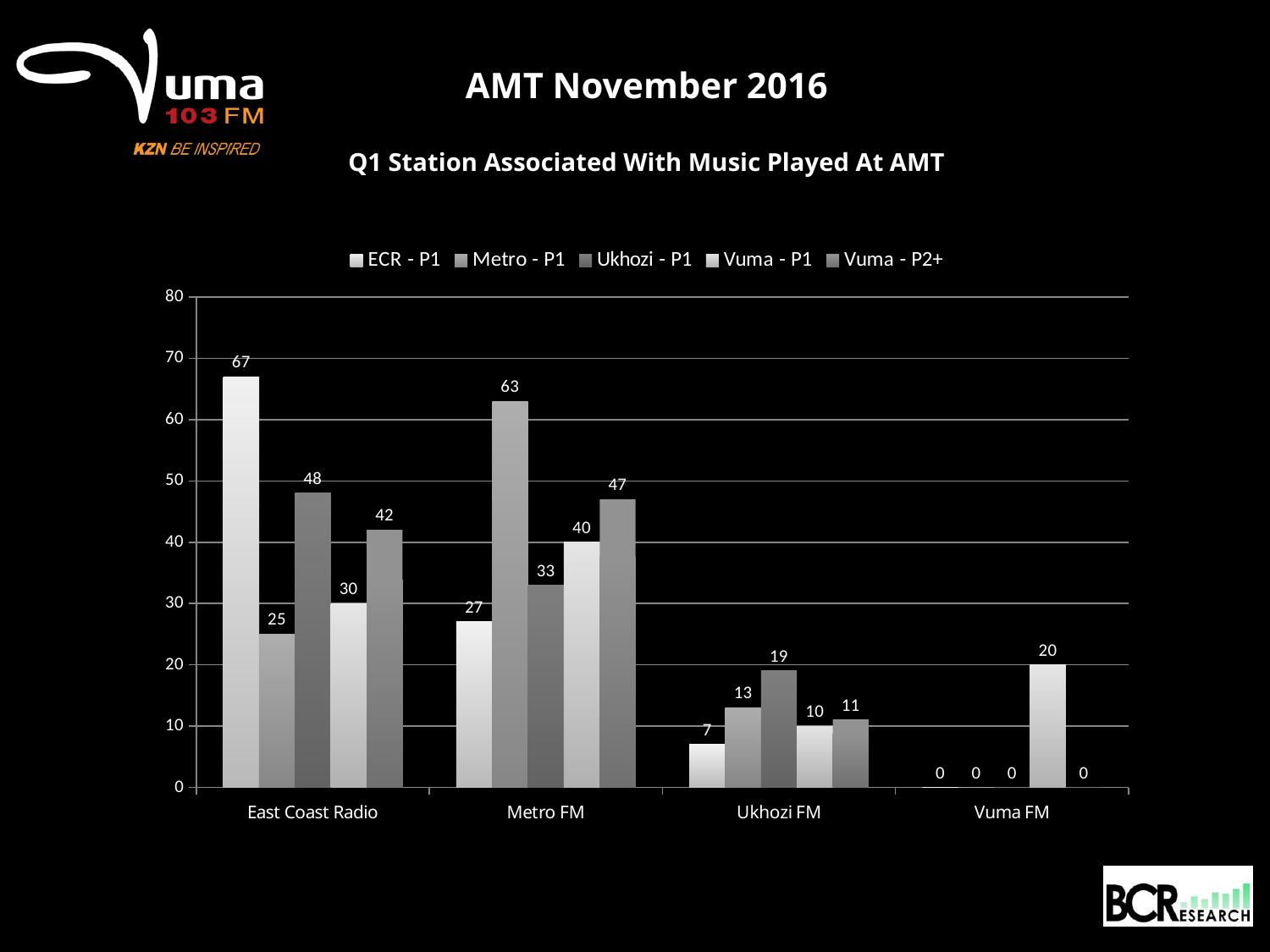
What is the title of the chart? Q1 Station Associated With Music Played At AMT Which series has the lowest value at Ukhozi FM? ECR - P1 What is the difference between the Metro - P1 value and the ECR - P1 value at Metro FM? 36 What is the value for ECR - P1 at East Coast Radio? 67 How many series does the legend list? 5 What is the value for Metro - P1 at Metro FM? 63 What kind of chart is shown on the slide? Bar chart What is the value for Ukhozi - P1 at Ukhozi FM? 19 What is the value for Vuma - P1 at Vuma FM? 20 How many station categories are shown on the x axis? 4 Which is larger at East Coast Radio: the Ukhozi - P1 value or the Vuma - P2+ value? Ukhozi - P1 Which series has the highest value at East Coast Radio? ECR - P1